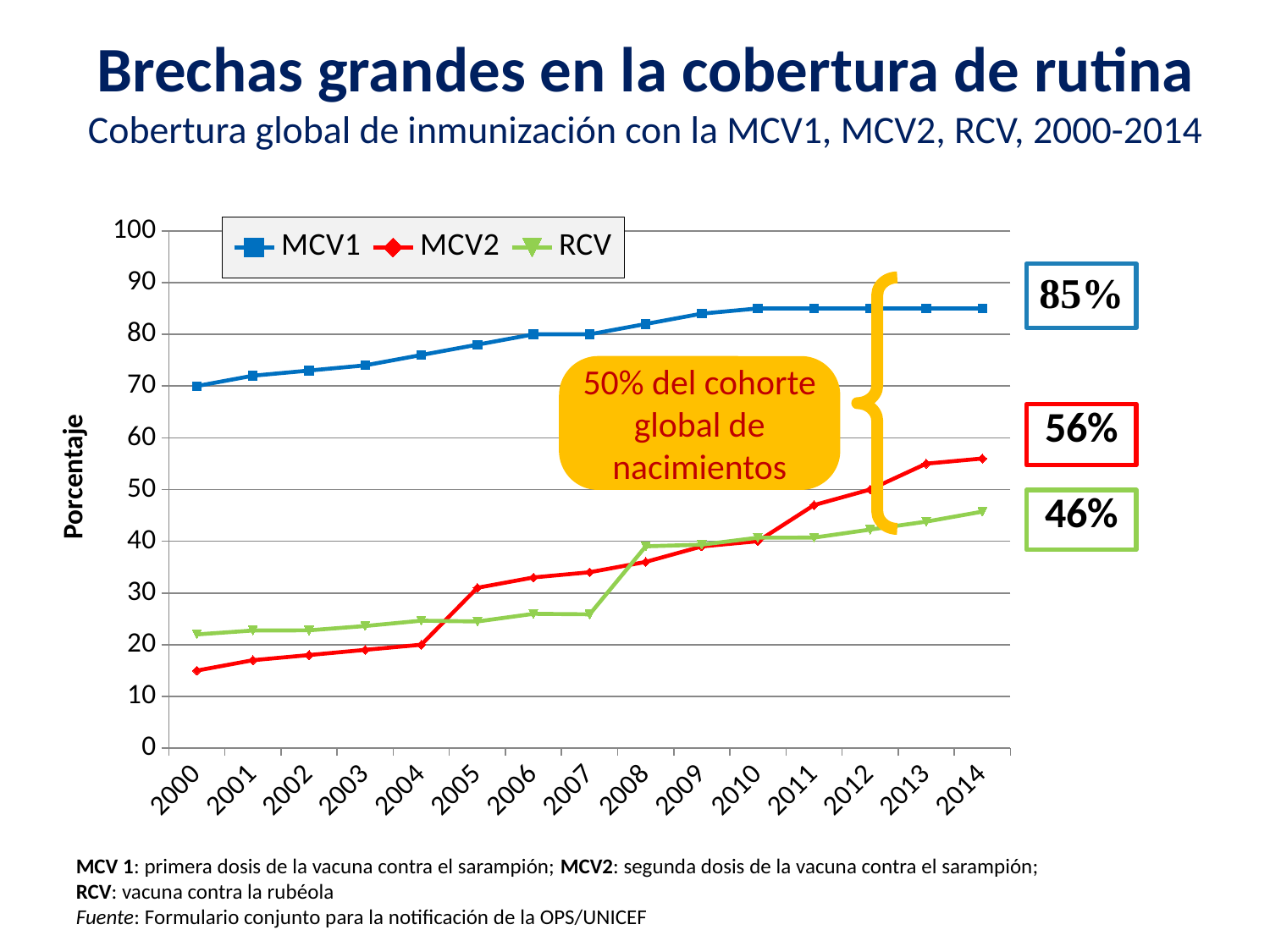
How many years are plotted along the x axis? 15 What is the MCV1 coverage value shown for 2014? 85% How many series does the legend list? 3 What is the MCV2 coverage value shown for 2014? 56% Is the value for MCV2 in 2000 greater or less than 20? less Does the MCV1 series rise or fall from 2000 to 2014? rise In 2014, which is larger, the MCV2 value or the RCV value? MCV2 What is the RCV coverage value shown for 2014? 46% Which series has the highest value in 2014? MCV1 What is the difference between the MCV1 and MCV2 values shown for 2014? 29 percentage points What is the label on the y axis? Porcentaje What kind of chart is shown on the slide? line chart